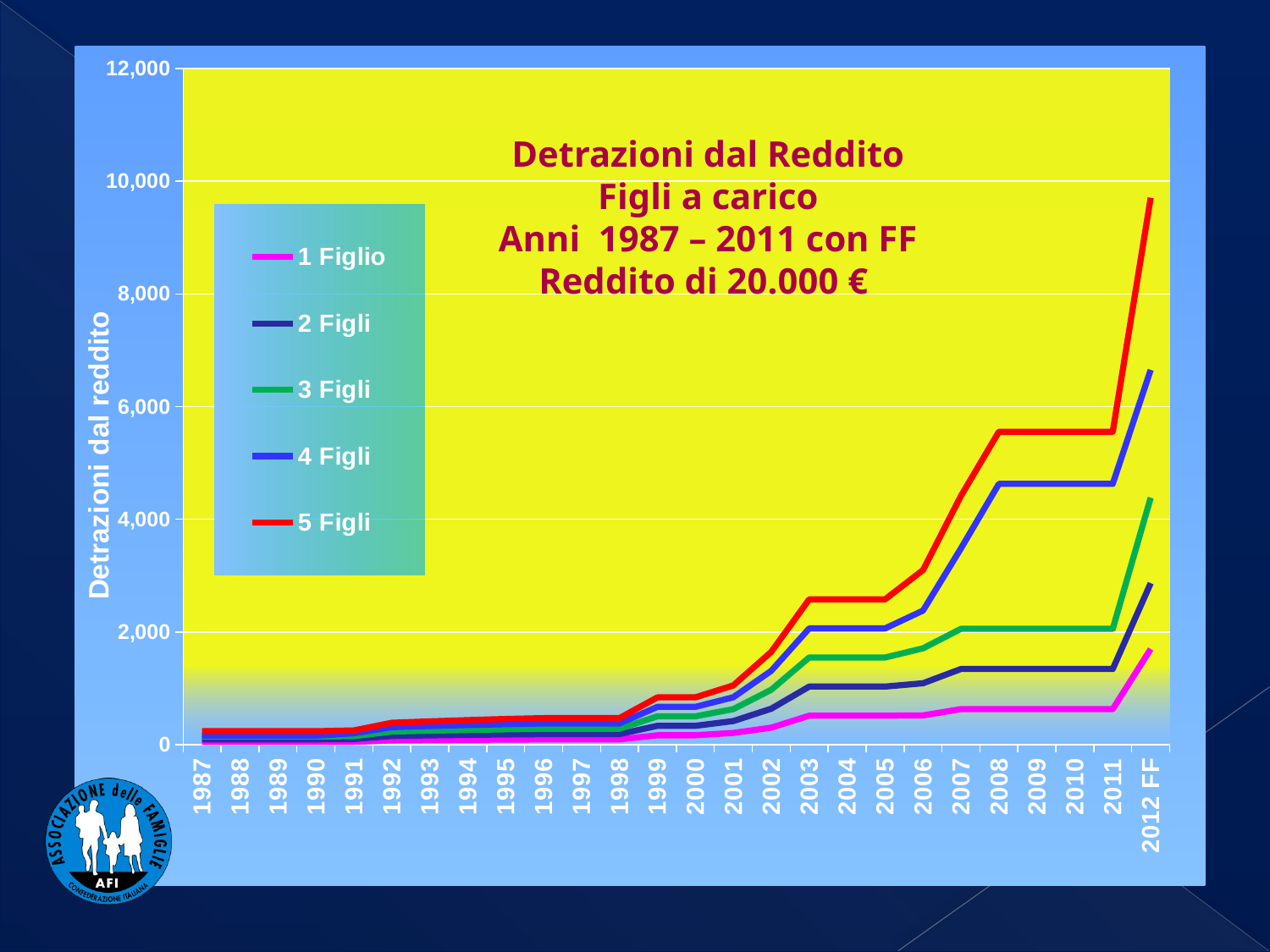
Is the value for 5 Figli at 2012 FF greater or less than 8,000? greater Which series has the highest value at 2012 FF? 5 Figli How many points are plotted along the x axis (from 1987 to 2012 FF)? 26 In 2008, which is larger: the value for 5 Figli or the value for 4 Figli? 5 Figli What kind of chart is shown on the slide? line chart Which series has the lowest value at 2012 FF? 1 Figlio Is the value for 1 Figlio in 2011 greater or less than 2,000? less What colour is the line for 5 Figli in the legend? red How many series does the legend list? 5 Is the value for 4 Figli at 2012 FF greater or less than 6,000? greater Do the values for 5 Figli rise or fall from 1987 to 2012 FF? rise